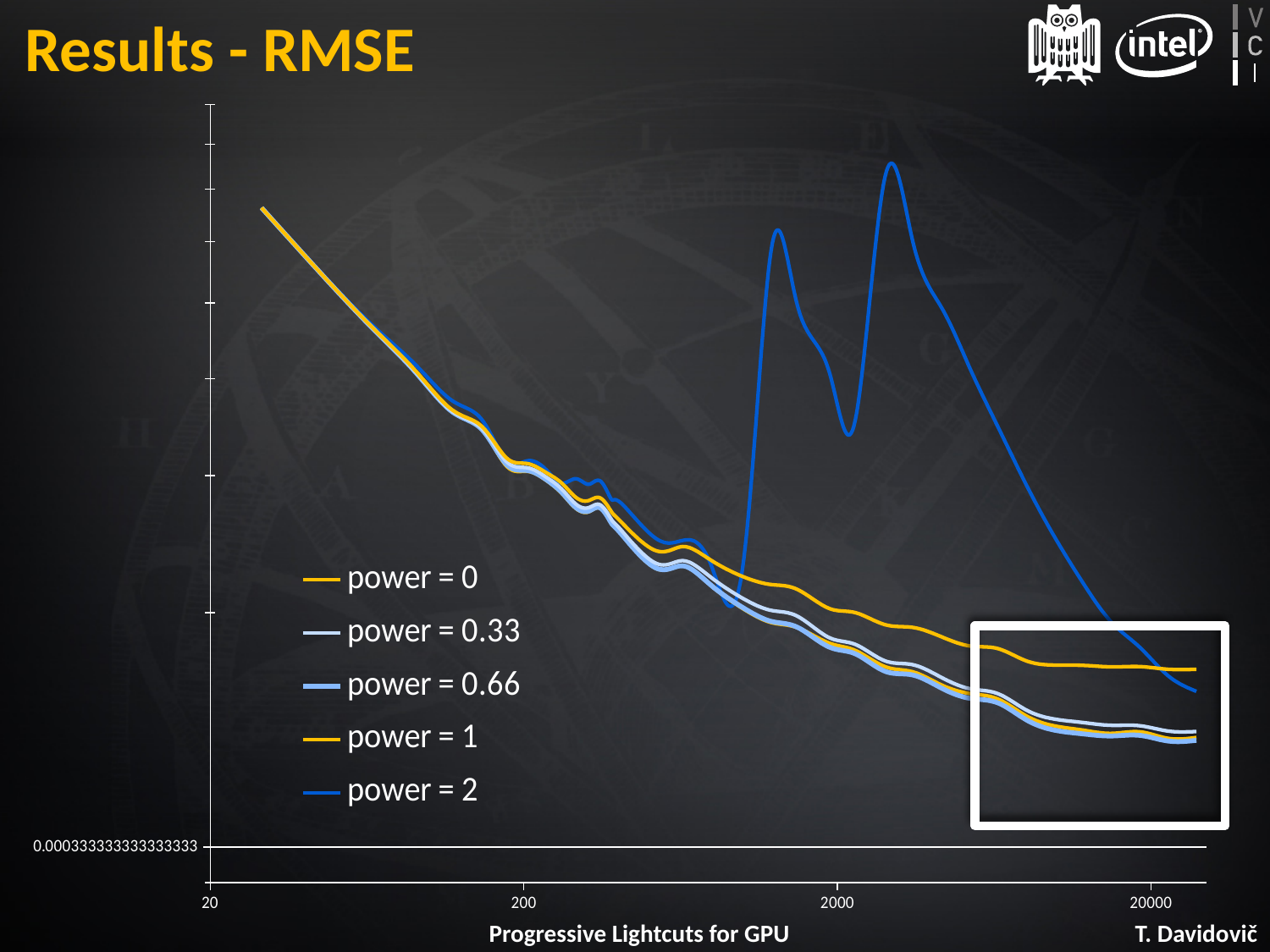
What kind of chart is shown on the slide? line chart How many series does the legend list? 5 What value is printed as the y-axis label at the bottom of the axis? 0.000333333333333333 What are the legend entries of the chart? power = 0, power = 0.33, power = 0.66, power = 1, power = 2 What is the smallest tick label shown on the x axis? 20 Do the plotted RMSE values generally rise or fall as the x axis increases from 20 to 20000? fall What is the largest tick label shown on the x axis? 20000 Which series shows two large spikes between x = 2000 and x = 20000? power = 2 What is the title of the slide containing the chart? Results - RMSE How many tick labels are shown on the x axis? 4